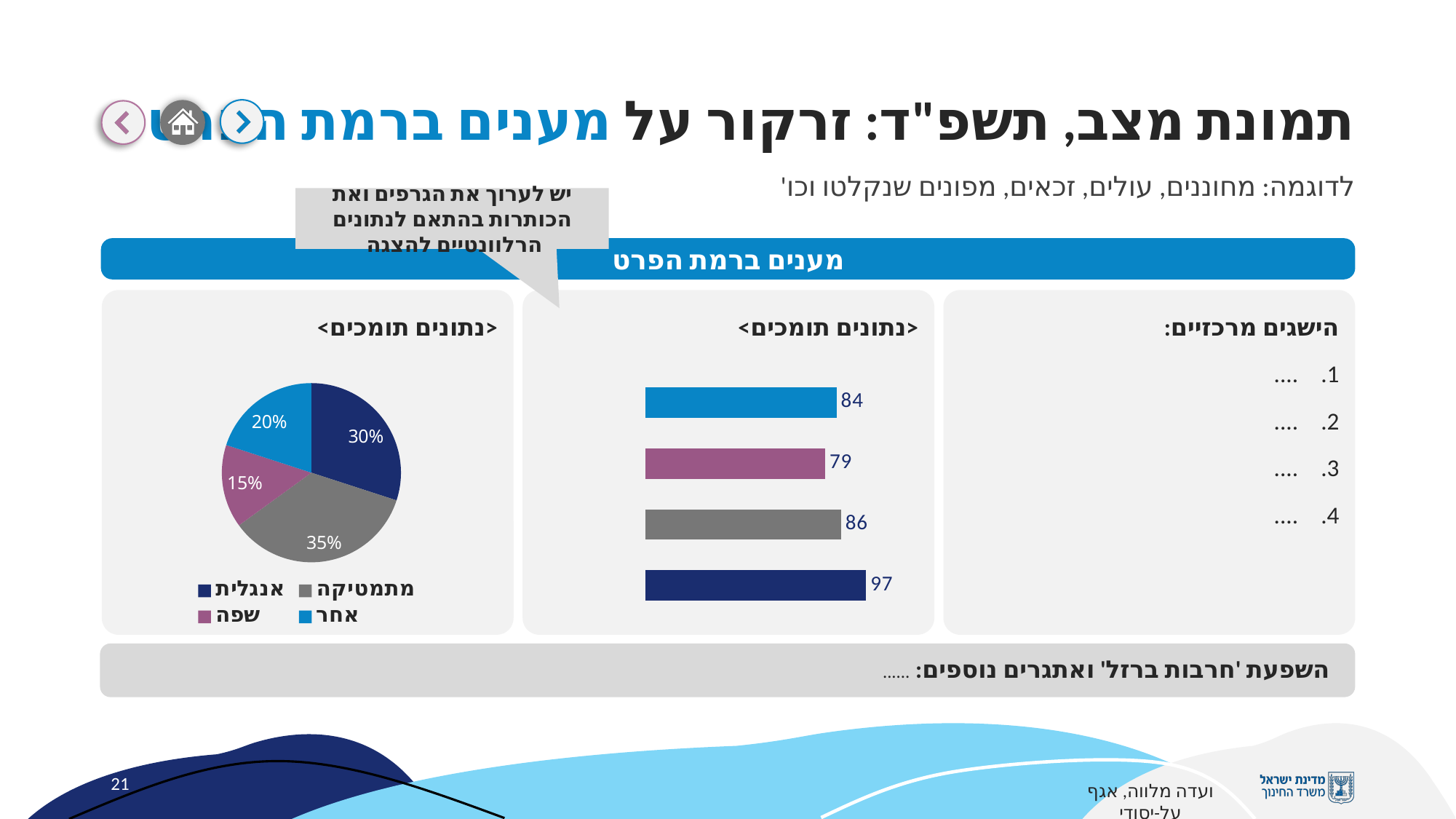
In the pie chart in the left panel, how many categories does the legend list? 4 In the bar chart in the middle panel, what is the value of the top bar? 84 In the pie chart in the left panel, what share does מתמטיקה have? 35% What kind of chart is the chart in the left panel of the slide? pie chart In the pie chart in the left panel, what share does שפה have? 15% What kind of chart is the chart in the middle panel of the slide? bar chart In the bar chart in the middle panel, what is the highest value shown? 97 In the bar chart in the middle panel, what is the value of the bottom bar? 97 In the bar chart in the middle panel, what is the difference between the bottom bar (97) and the second bar from the top (79)? 18 In the bar chart in the middle panel, what is the lowest value shown? 79 In the bar chart in the middle panel, how many bars are there? 4 In the pie chart in the left panel, which category has the largest slice? מתמטיקה